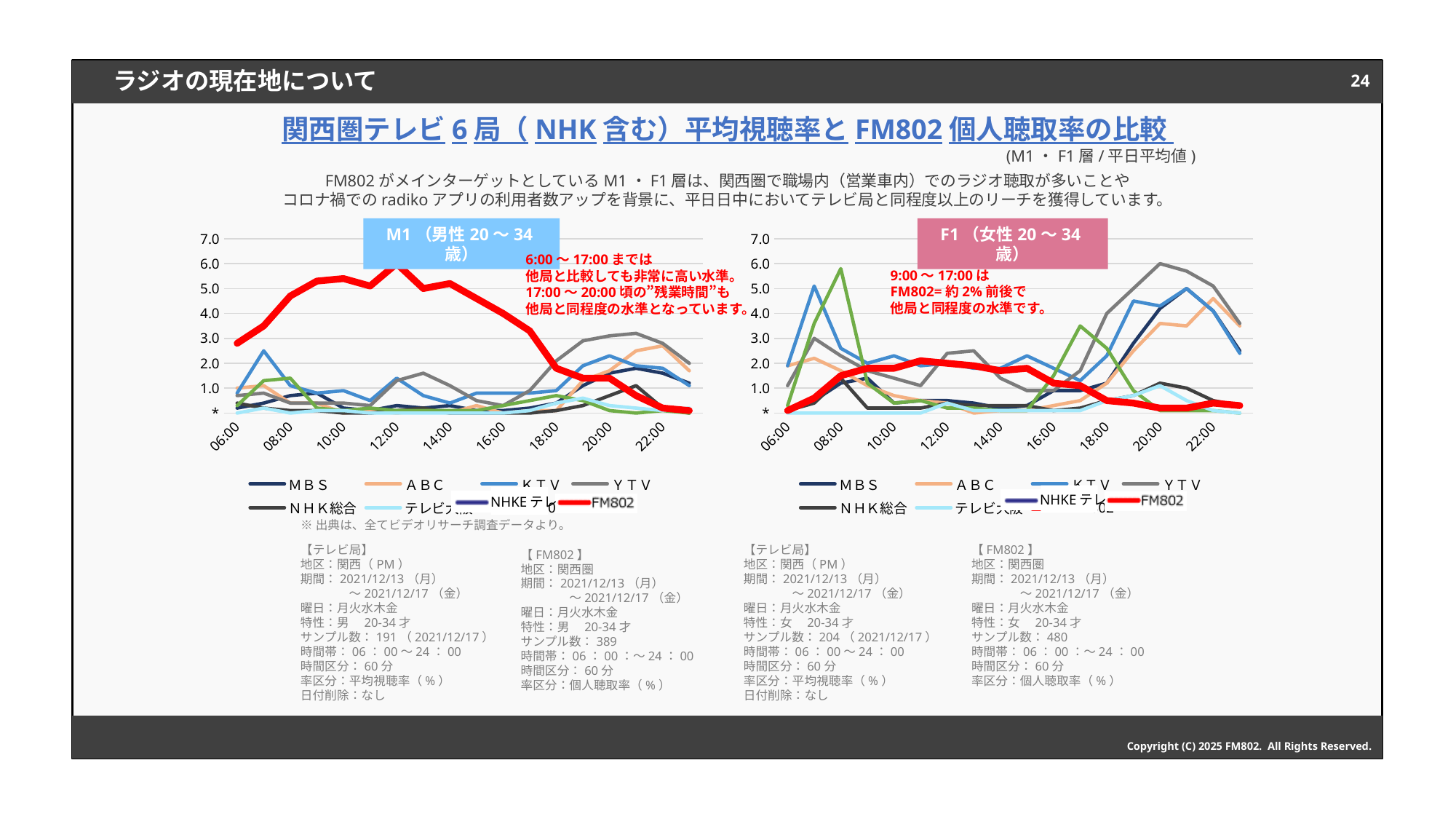
In the M1 (男性 20～34歳) chart, is the FM802 value at 22:00 greater or less than 1.0? less In the F1 (女性 20～34歳) chart, is the FM802 value at 12:00 greater or less than 1.0? greater In the M1 (男性 20～34歳) chart, which series reaches the highest value? FM802 In the F1 (女性 20～34歳) chart, what colour is the FM802 line? red In the F1 (女性 20～34歳) chart, is the YTV value at 20:00 greater or less than 5.0? greater In the F1 (女性 20～34歳) chart, does the FM802 line rise or fall from 06:00 to 12:00? rise How many time labels are shown on the x axis of the M1 (男性 20～34歳) chart? 9 In the M1 (男性 20～34歳) chart, does the FM802 line rise or fall from 12:00 to 22:00? fall What kind of chart is the M1 (男性 20～34歳) chart on the left? line chart How many series does the legend of the F1 (女性 20～34歳) chart list? 8